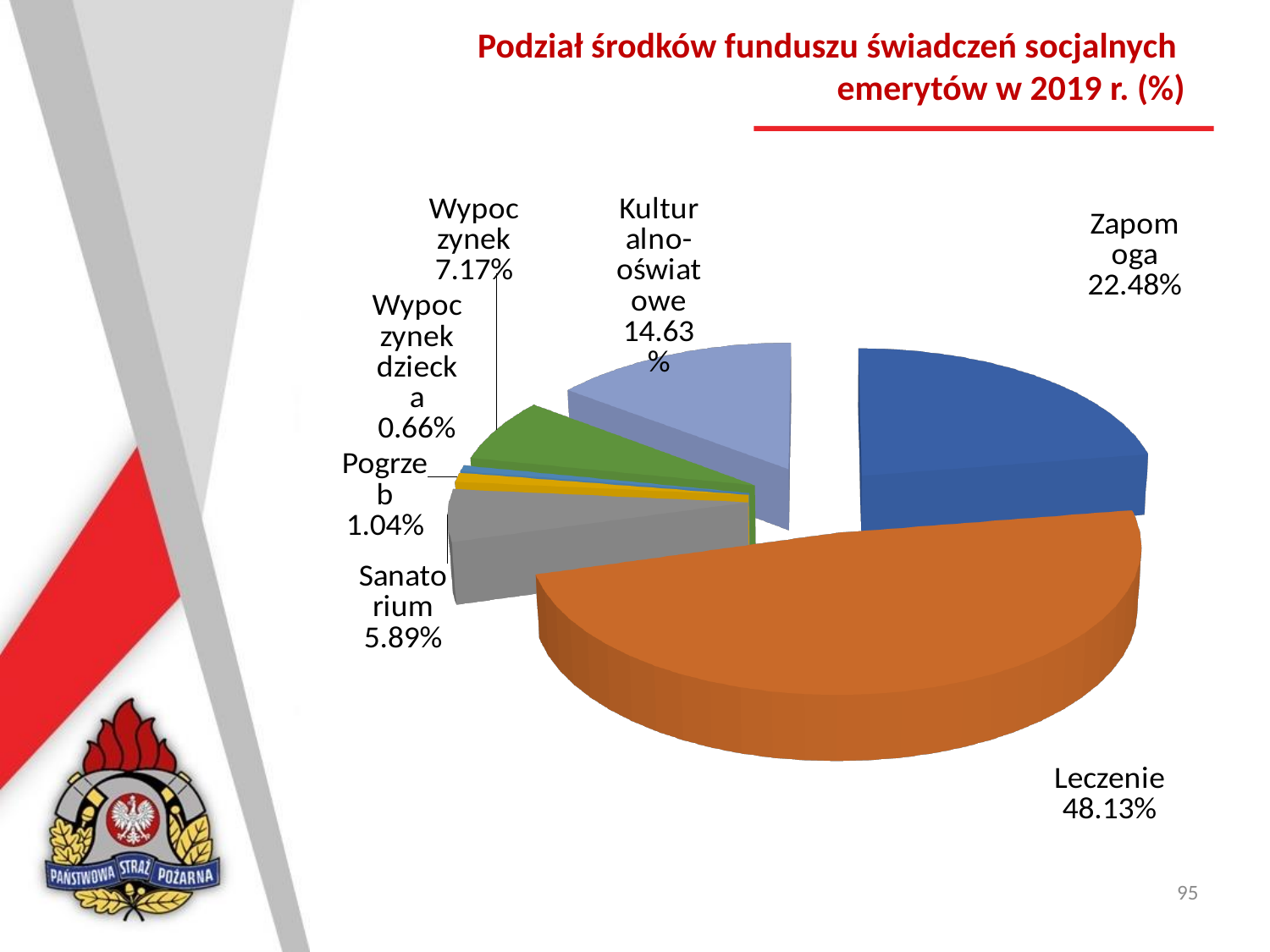
What share of the fund went to Sanatorium? 5.89% What is the title of the chart? Podział środków funduszu świadczeń socjalnych emerytów w 2019 r. (%) What kind of chart is shown on the slide? pie chart Which category has the largest share of the fund? Leczenie What is the difference between the shares for Leczenie and Zapomoga? 25.65% How many categories are shown in the pie chart? 7 What share of the fund went to Pogrzeb? 1.04% What share of the fund went to Zapomoga? 22.48% What share of the fund went to Leczenie? 48.13% Which category has the smallest share of the fund? Wypoczynek dziecka What share of the fund went to Kulturalno-oświatowe? 14.63% Which is larger, the share for Wypoczynek or the share for Sanatorium? Wypoczynek